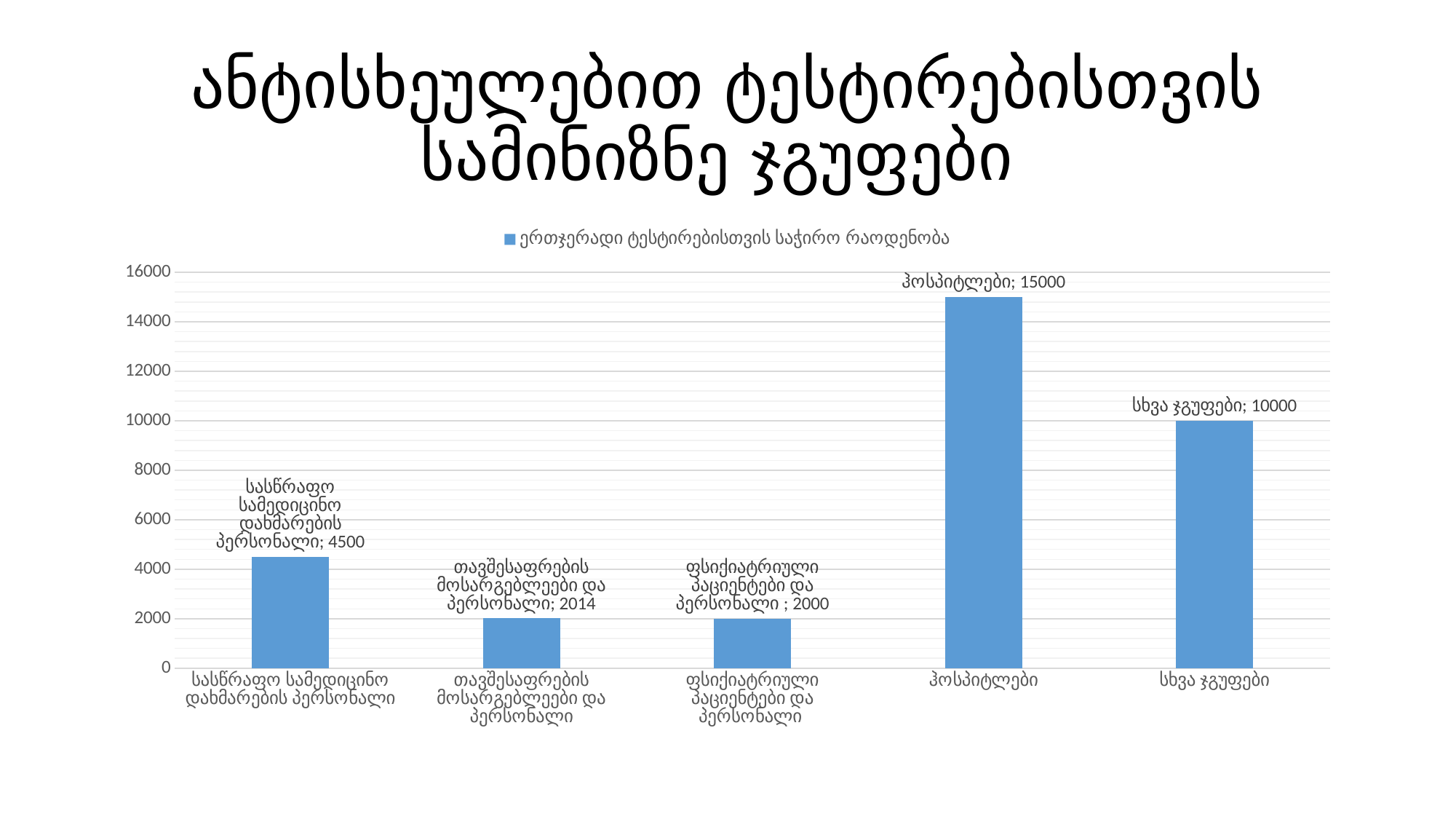
Which is larger, the value for სასწრაფო სამედიცინო დახმარების პერსონალი or the value for სხვა ჯგუფები? სხვა ჯგუფები What is the value for სხვა ჯგუფები? 10000 What is the value for ჰოსპიტლები? 15000 What is the value for ფსიქიატრიული პაციენტები და პერსონალი? 2000 Which category has the lowest value? ფსიქიატრიული პაციენტები და პერსონალი What is the value for თავშესაფრების მოსარგებლეები და პერსონალი? 2014 What is the value for სასწრაფო სამედიცინო დახმარების პერსონალი? 4500 What is the legend entry of the chart? ერთჯერადი ტესტირებისთვის საჭირო რაოდენობა How many categories are shown on the x axis? 5 Which category has the highest value? ჰოსპიტლები What type of chart is shown on the slide? bar chart What is the difference between the values for ჰოსპიტლები and სხვა ჯგუფები? 5000